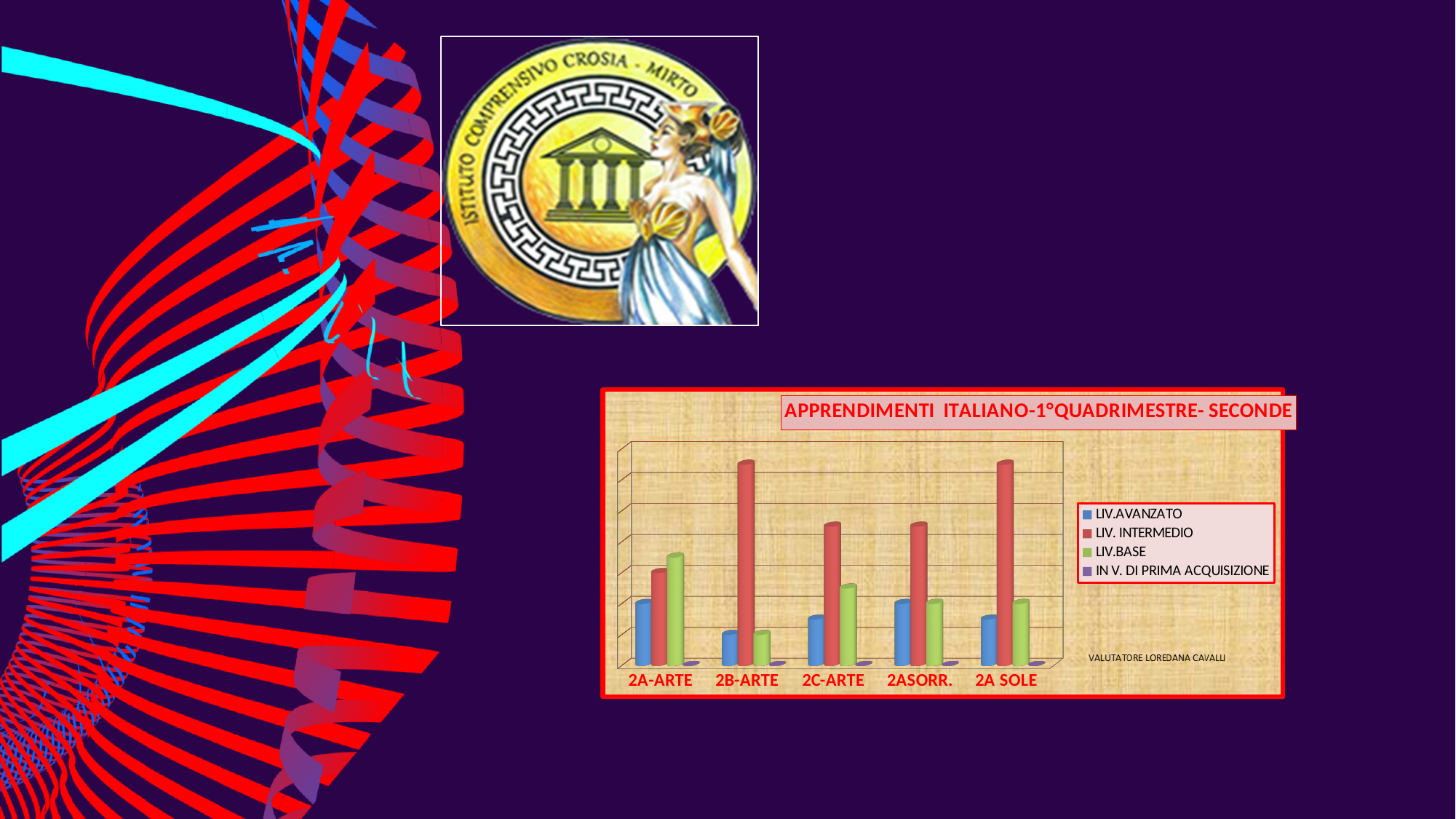
How many series does the chart's legend list? 4 Which category has the lowest LIV.BASE bar? 2B-ARTE Which series has the tallest bar for 2B-ARTE? LIV. INTERMEDIO Which is larger: LIV.AVANZATO for 2A-ARTE or LIV.AVANZATO for 2B-ARTE? 2A-ARTE Which colour represents LIV. INTERMEDIO in the chart's legend? red Which category has the highest LIV.BASE bar? 2A-ARTE Which series has the tallest bar for 2A SOLE? LIV. INTERMEDIO For 2A-ARTE, which is larger: LIV.BASE or LIV. INTERMEDIO? LIV.BASE What is the title of the chart? APPRENDIMENTI ITALIANO-1°QUADRIMESTRE- SECONDE What kind of chart is shown on the slide? bar chart Which category has the lowest LIV.AVANZATO bar? 2B-ARTE How many categories (classes) are shown on the x axis of the chart? 5